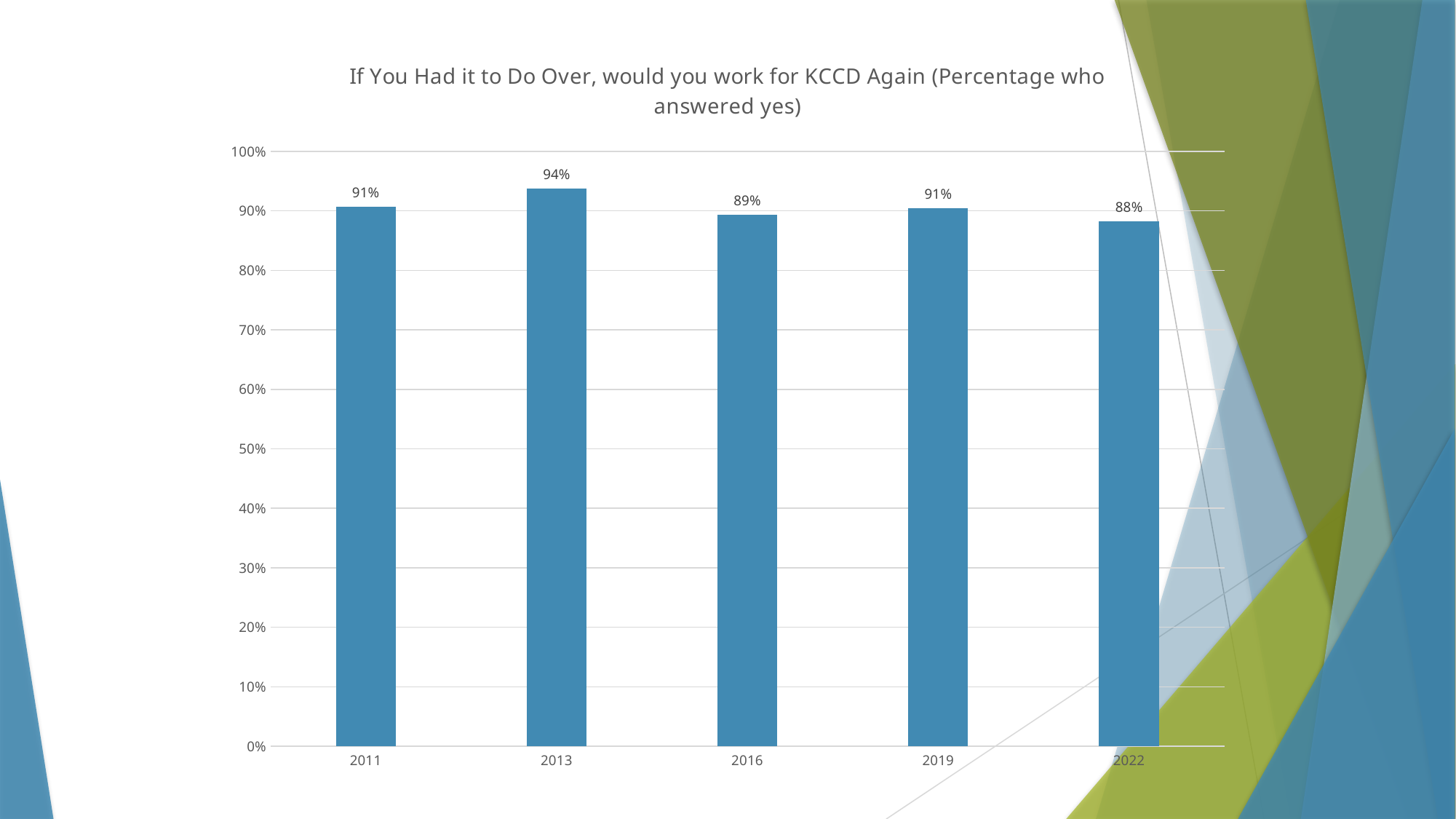
Which year has the highest percentage who answered yes? 2013 What is the difference between the 2013 value and the 2022 value? 6% What kind of chart is shown on the slide? Bar chart Which year has the lowest percentage who answered yes? 2022 What percentage answered yes in 2013? 94% Does the value rise or fall from 2019 to 2022? Fall What is the title of the chart? If You Had it to Do Over, would you work for KCCD Again (Percentage who answered yes) How many years are shown on the x axis? 5 What percentage answered yes in 2022? 88% Which is larger, the value for 2011 or the value for 2016? 2011 What percentage answered yes in 2016? 89% Is the value for 2019 greater or less than 80%? greater